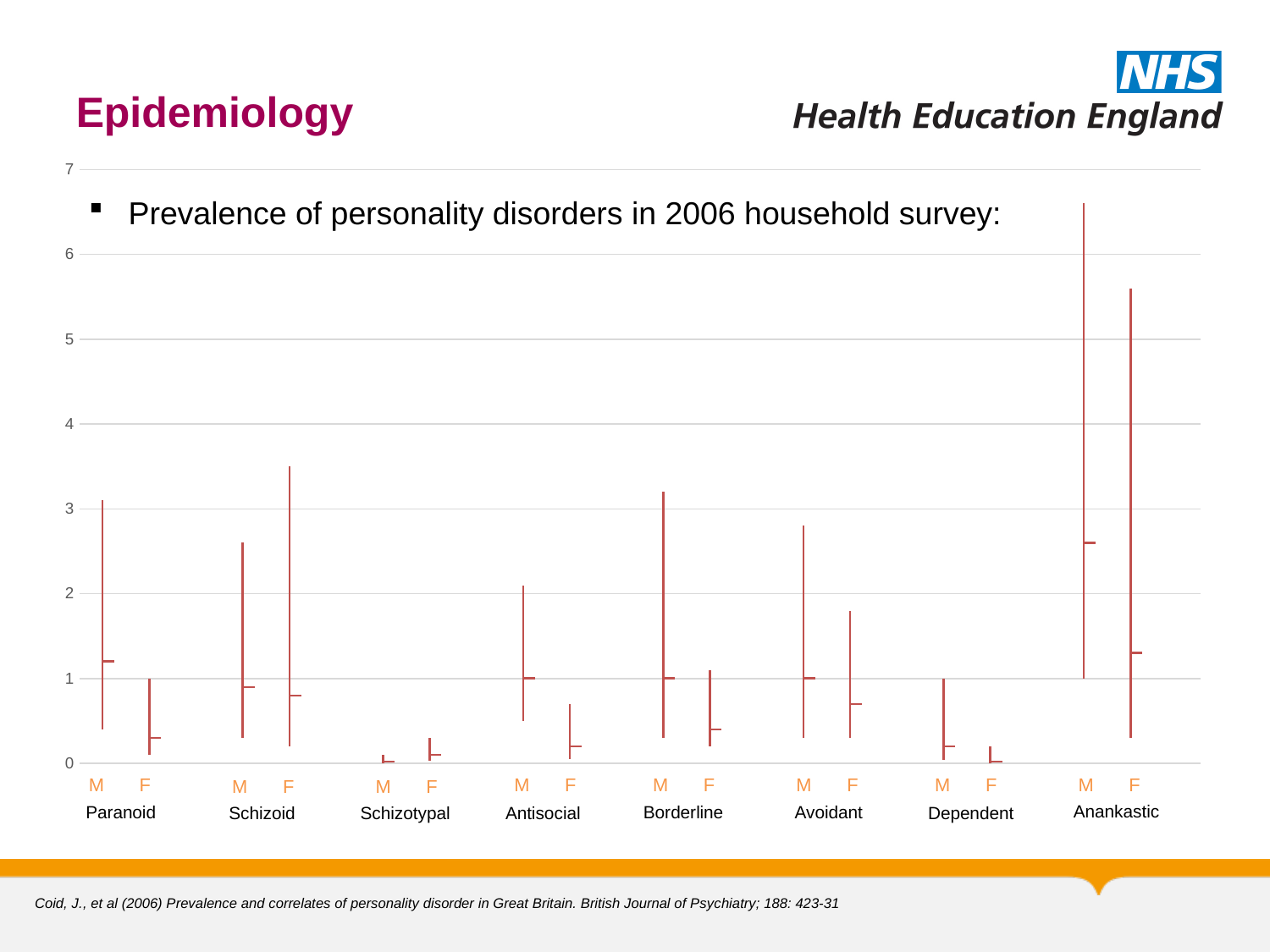
Is the top of the line for Schizoid F greater or less than 3? greater Which reaches higher on the chart, the line for Borderline M or the line for Borderline F? Borderline M Is the top of the line for Anankastic M greater or less than 6? greater What is the highest value labelled on the vertical axis of the chart? 7 How many personality disorders are shown along the x axis of the chart? 8 Are the values for Schizotypal F greater or less than 1? less Which personality disorder has the highest value shown on the chart? Anankastic What is the title text above the chart? Prevalence of personality disorders in 2006 household survey: Which personality disorder has the lowest values shown on the chart? Schizotypal Which reaches higher on the chart, the line for Schizoid M or the line for Schizoid F? Schizoid F